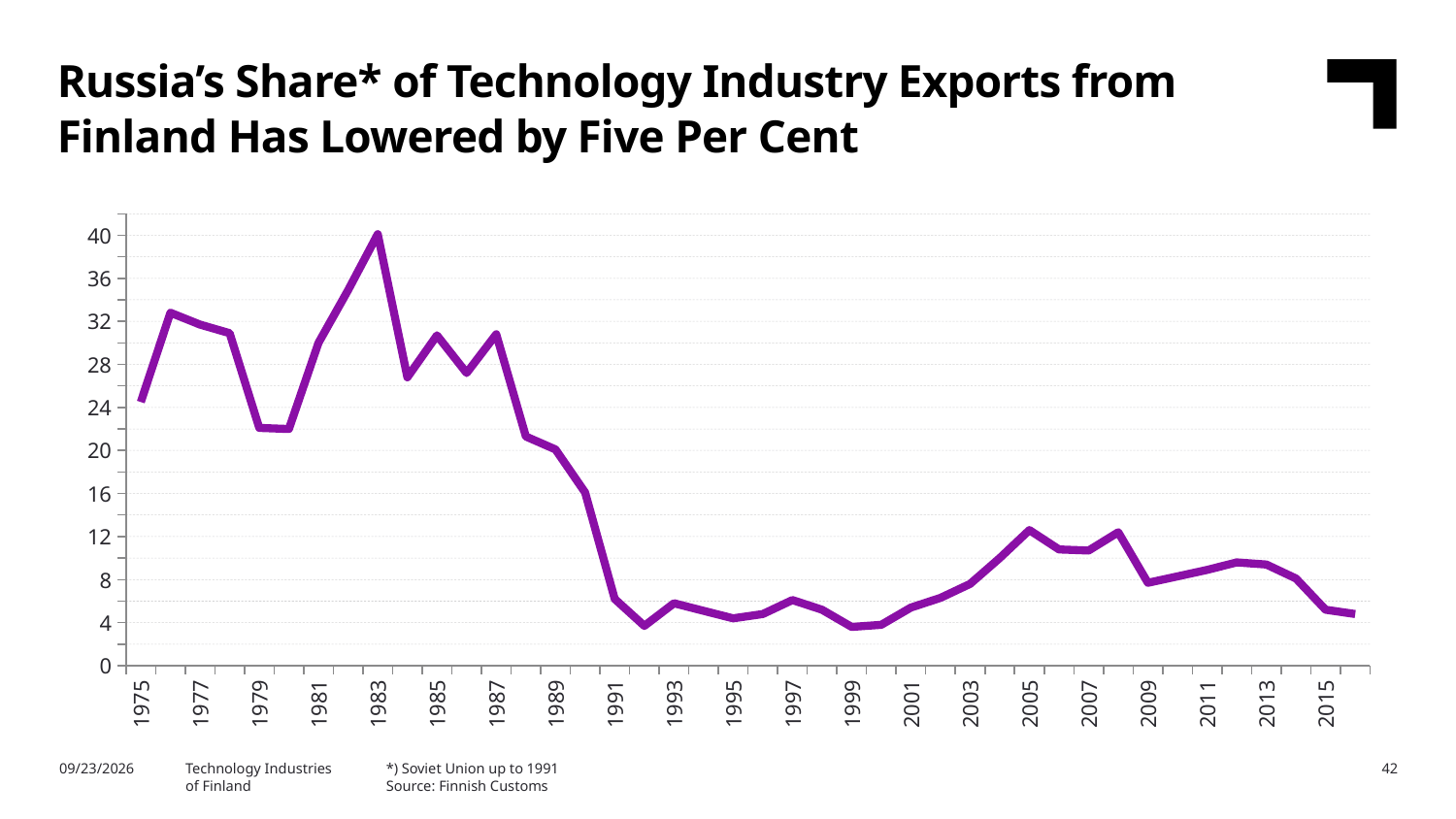
In which year does Russia's share of technology industry exports reach its highest value? 1983 How many year labels are shown on the x axis? 21 Is the value for 1991 greater or less than 8? less Is the value for 2013 greater or less than 8? greater What is the highest value shown on the y axis? 40 What kind of chart is shown on the slide? line chart Is the value for 1979 greater or less than 24? less Does the line rise or fall overall from 1975 to 2016? fall Which year has the larger value, 1977 or 2005? 1977